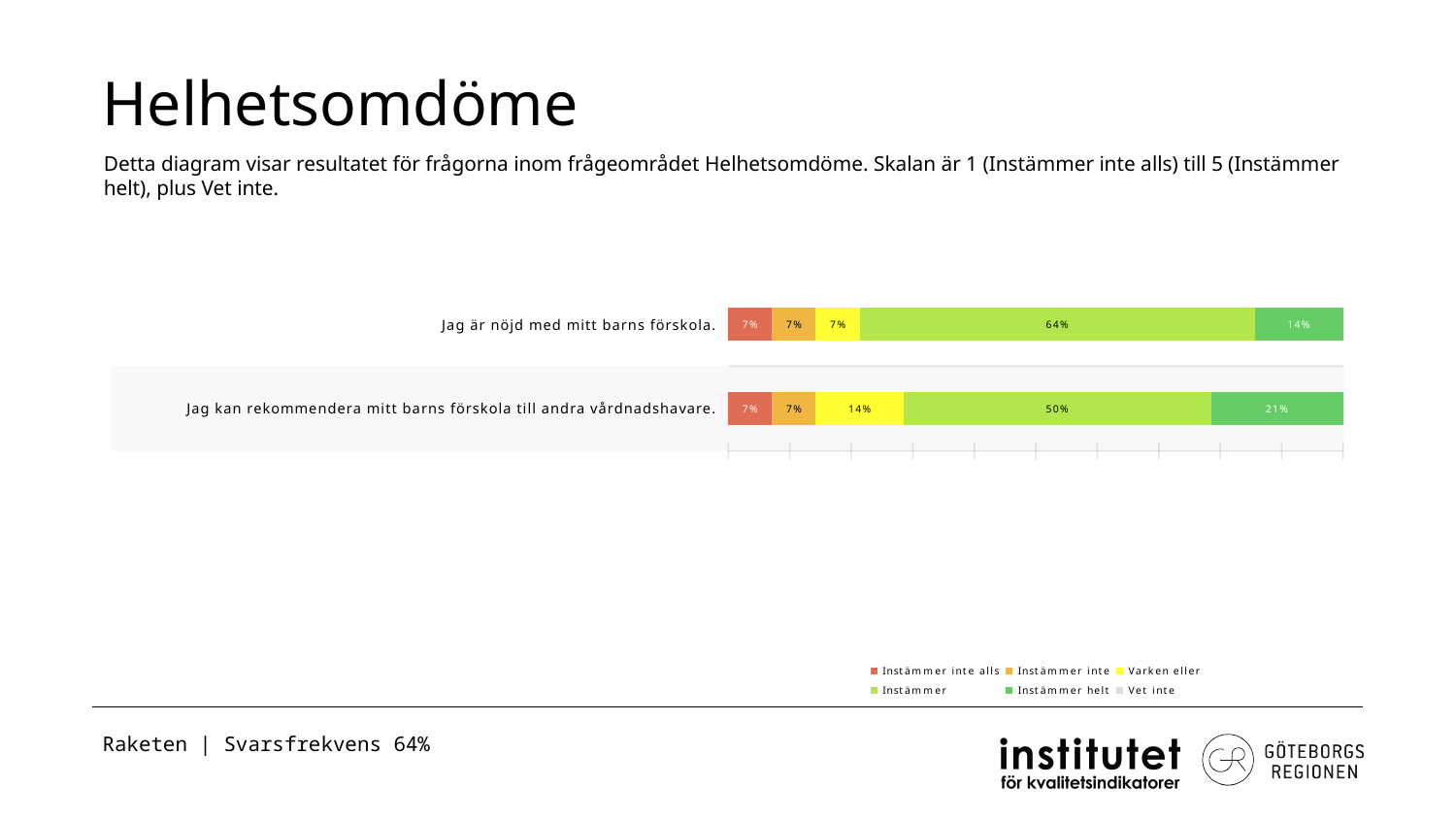
What is the difference between the "Instämmer helt" shares of the two statements? 7% How many series does the legend list? 6 How many statements (categories) are shown in the chart? 2 What percentage of respondents answered "Instämmer helt" for "Jag kan rekommendera mitt barns förskola till andra vårdnadshavare."? 21% What kind of chart is shown on the slide? Stacked bar chart What is the combined share of "Instämmer" and "Instämmer helt" for "Jag är nöjd med mitt barns förskola."? 78% What is the difference between the "Instämmer" shares of the two statements? 14% What percentage of respondents answered "Instämmer" for "Jag är nöjd med mitt barns förskola."? 64% Which statement has the higher share of "Instämmer helt" responses? Jag kan rekommendera mitt barns förskola till andra vårdnadshavare. What percentage of respondents answered "Instämmer helt" for "Jag är nöjd med mitt barns förskola."? 14% What percentage of respondents answered "Varken eller" for "Jag kan rekommendera mitt barns förskola till andra vårdnadshavare."? 14% Which statement has the higher share of "Instämmer" responses? Jag är nöjd med mitt barns förskola.